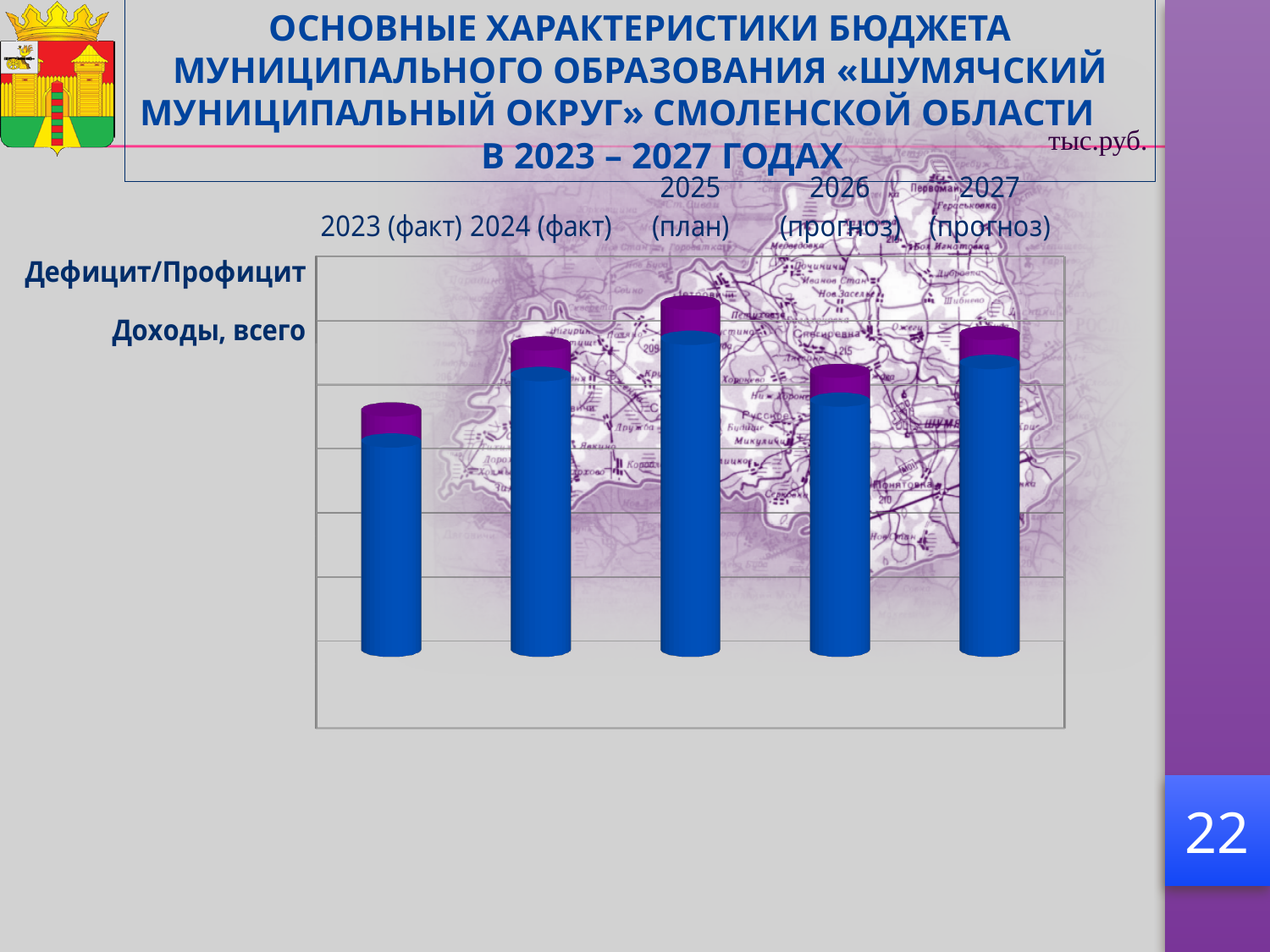
What kind of chart is shown on the slide? bar chart Which bar is taller, 2024 (факт) or 2026 (прогноз)? 2024 (факт) In what units are the chart values given, according to the slide? тыс.руб. Which year has the tallest bar in the chart? 2025 (план) Do the bars rise or fall from 2025 (план) to 2026 (прогноз)? fall Which bar is taller, 2023 (факт) or 2026 (прогноз)? 2026 (прогноз) Which year has the shortest bar in the chart? 2023 (факт) How many year categories are plotted along the x axis of the chart? 5 Do the bars rise or fall from 2023 (факт) to 2025 (план)? rise